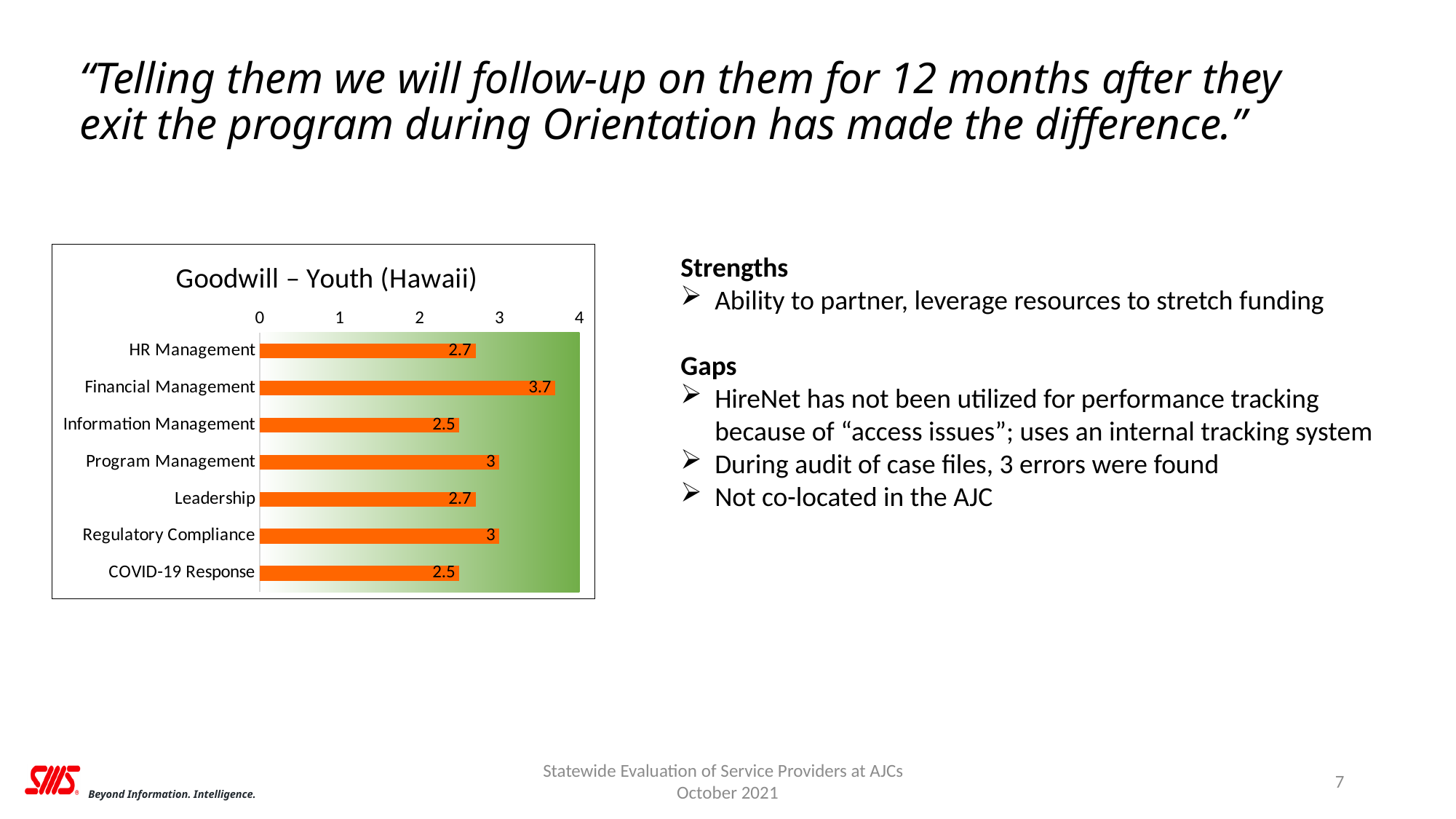
What is the value for Financial Management? 3.7 What kind of chart is shown on the slide? bar chart Which category has the highest value? Financial Management What is the value for COVID-19 Response? 2.5 What is the difference between the values for Financial Management and Information Management? 1.2 What is the value for Program Management? 3 What is the title of the chart? Goodwill – Youth (Hawaii) What is the value for Leadership? 2.7 Which is larger, the value for HR Management or the value for Regulatory Compliance? Regulatory Compliance What is the maximum value shown on the chart's value axis? 4 Is the value for Financial Management greater or less than 3? greater How many categories are shown in the chart? 7